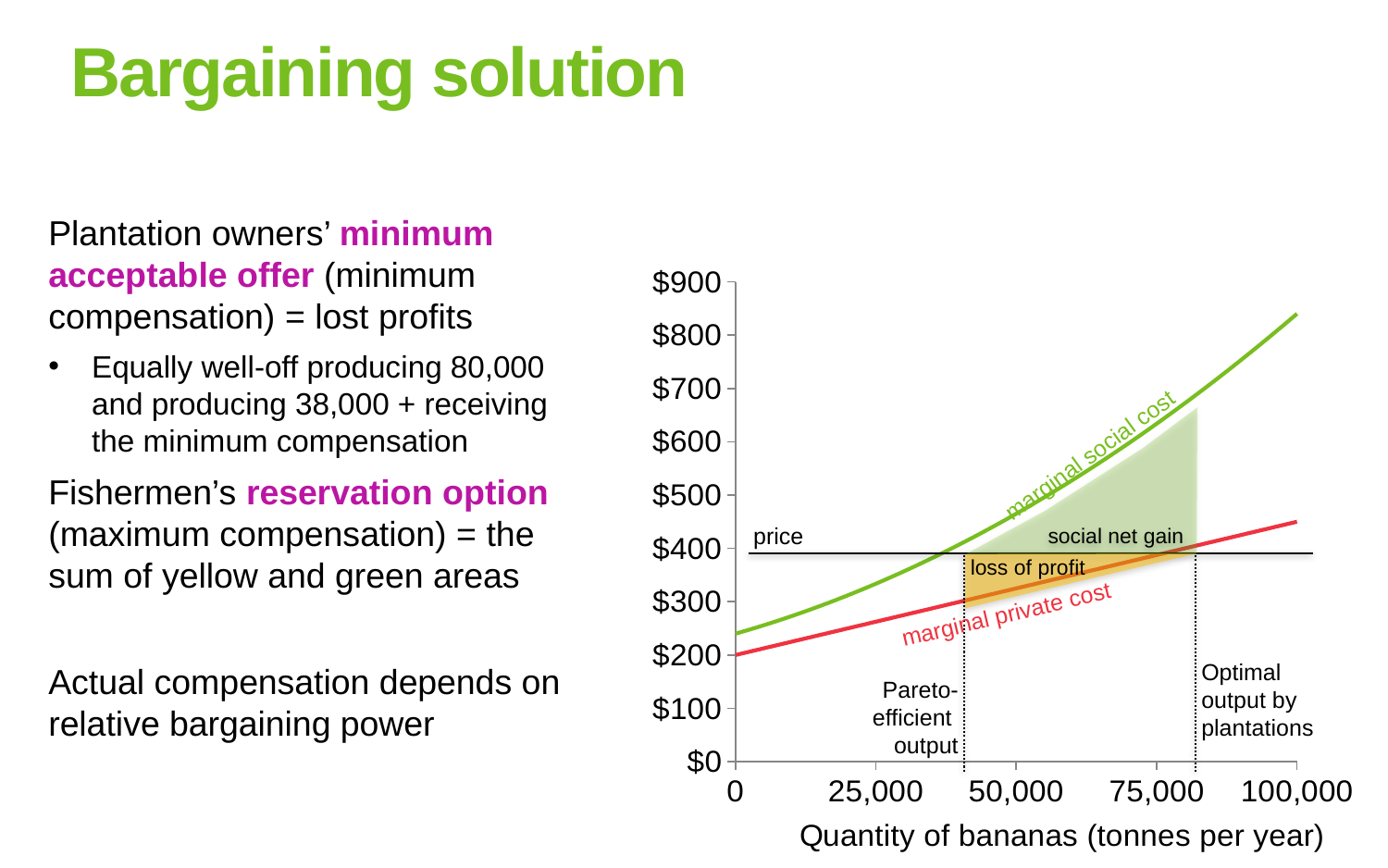
Is the marginal social cost at 100,000 tonnes greater or less than $800? greater Does the marginal social cost curve rise or fall as quantity increases along the x axis? rise Which is larger on the chart: the Pareto-efficient output or the optimal output by plantations? Optimal output by plantations At a quantity of 75,000 tonnes, which curve is higher: marginal social cost or marginal private cost? marginal social cost What is the highest value shown on the y axis of the chart? $900 What is the label of the x axis of the chart? Quantity of bananas (tonnes per year) At what price level is the horizontal 'price' line drawn on the chart? $400 What kind of chart is shown on the slide? line chart Is the marginal social cost at a quantity of 0 greater or less than $200? greater Is the marginal private cost at 50,000 tonnes greater or less than $400? less What is the value of the marginal private cost curve at a quantity of 0? $200